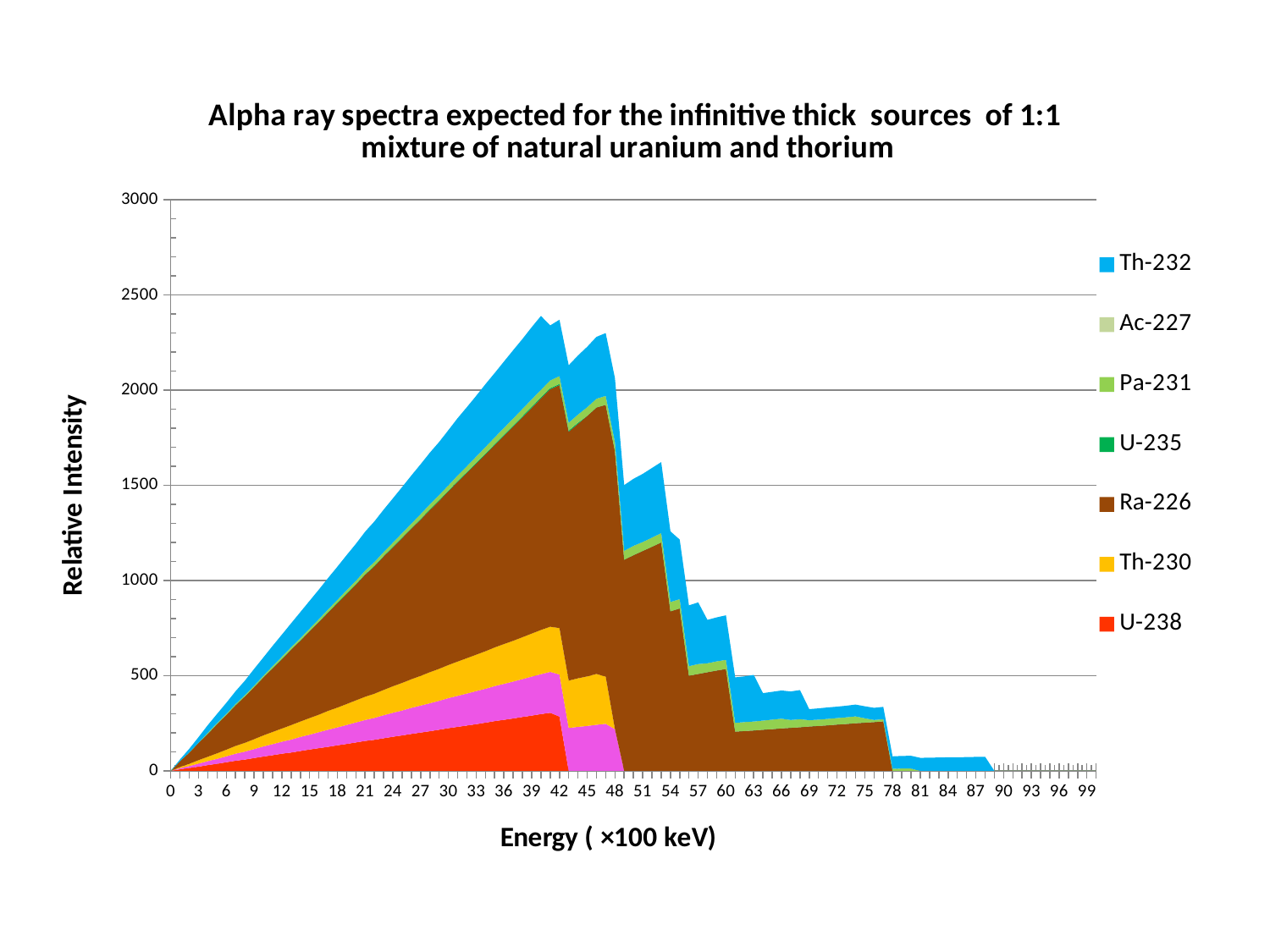
Does the total stacked value rise or fall as energy increases from 0 to 39? rise Which is larger at energy 39, the value for Ra-226 or the value for Th-230? Ra-226 How many series does the legend list? 7 Is the value for U-238 at energy 39 greater or less than 500? less What kind of chart is shown on the slide? Stacked area chart Is the total stacked value at energy 84 greater or less than 500? less Which series occupies the largest area in the chart? Ra-226 Is the total stacked value at energy 39 greater or less than 2000? greater What is the label of the x axis? Energy ( ×100 keV) What is the title of the chart? Alpha ray spectra expected for the infinitive thick sources of 1:1 mixture of natural uranium and thorium Does the total stacked value rise or fall as energy increases from 57 to 87? fall